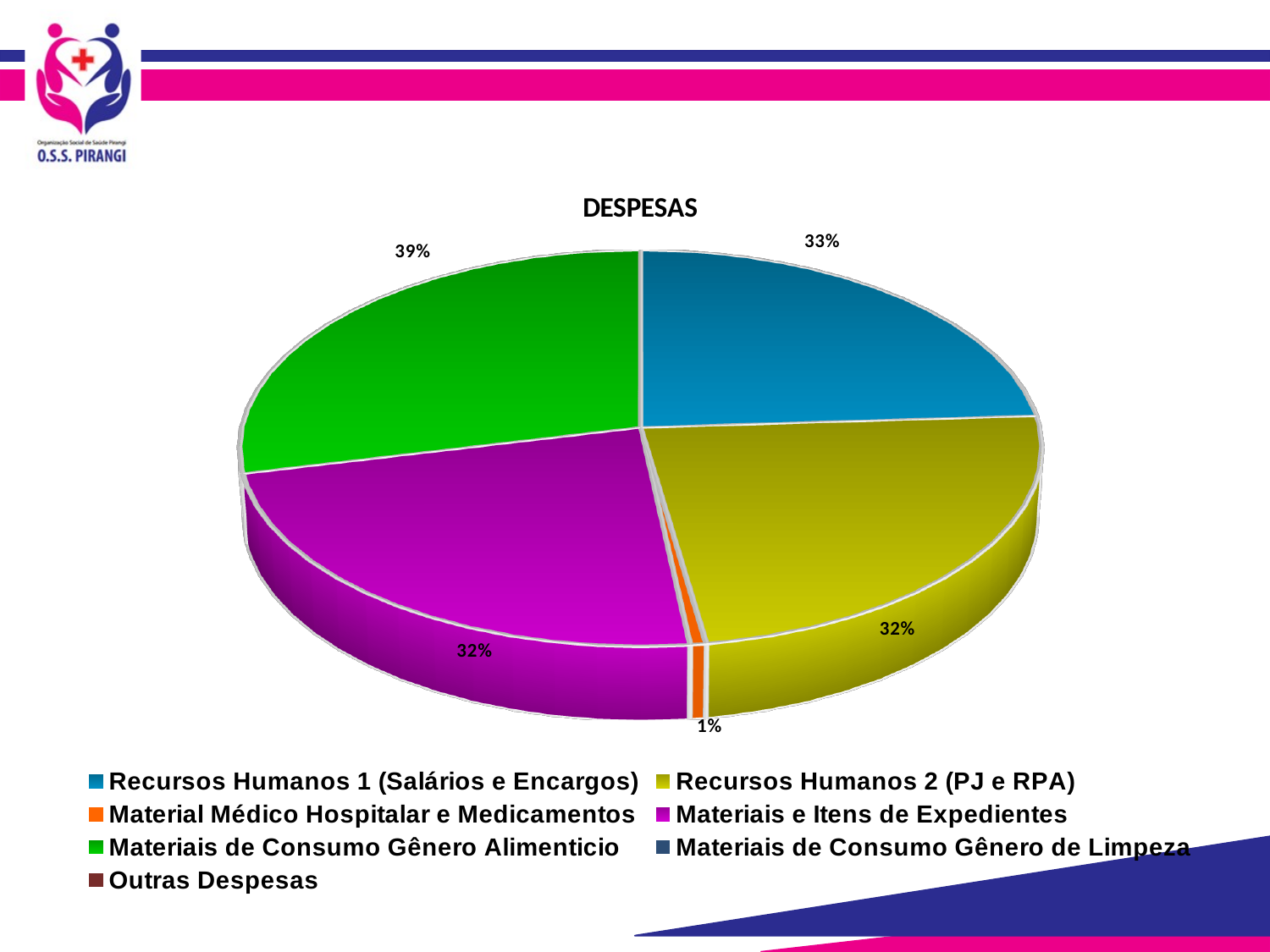
Which is larger: the slice for Recursos Humanos 1 (Salários e Encargos) or the slice for Recursos Humanos 2 (PJ e RPA)? Recursos Humanos 1 (Salários e Encargos) What share of the pie is Recursos Humanos 2 (PJ e RPA)? 32% What kind of chart is shown on the slide? Pie chart What share of the pie is Recursos Humanos 1 (Salários e Encargos)? 33% What share of the pie is Materiais de Consumo Gênero Alimenticio? 39% How many entries does the chart's legend list? 7 Which category has the largest slice of the pie? Materiais de Consumo Gênero Alimenticio What is the difference in percentage points between the Materiais de Consumo Gênero Alimenticio slice and the Recursos Humanos 1 (Salários e Encargos) slice? 6 percentage points Which labelled category has the smallest slice of the pie? Material Médico Hospitalar e Medicamentos What is the title of the chart? DESPESAS